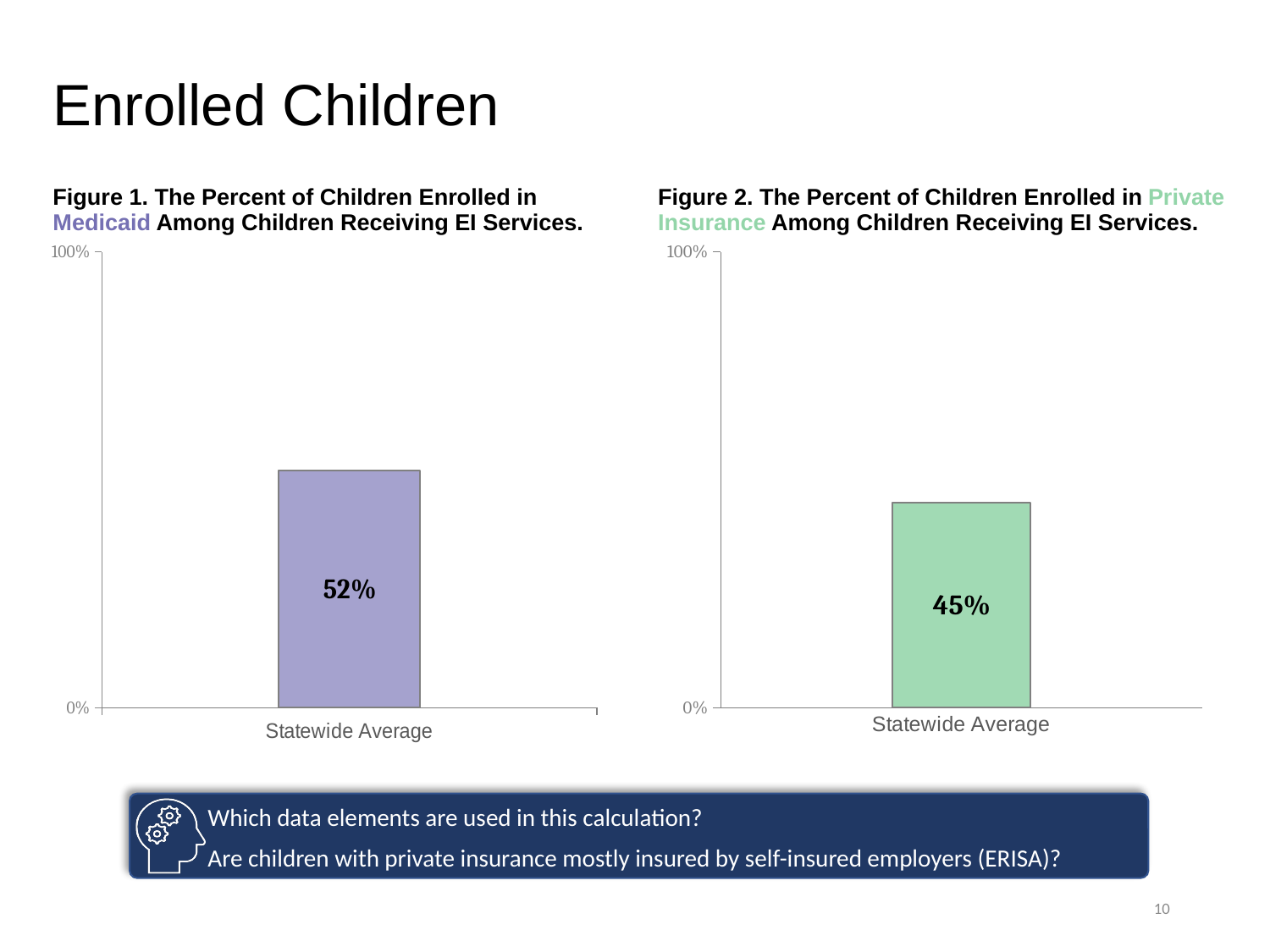
What is the title of the chart on the left? Figure 1. The Percent of Children Enrolled in Medicaid Among Children Receiving EI Services. Which is larger: the Statewide Average in Figure 1 or the Statewide Average in Figure 2? Figure 1 How many categories are plotted in Figure 2? 1 What kind of chart is Figure 2? Bar chart What is the difference between the Statewide Average in Figure 1 and the Statewide Average in Figure 2? 7% How many categories are plotted in Figure 1? 1 In Figure 1, is the value for Statewide Average greater or less than 100%? less What colour is the bar in Figure 2? Green In Figure 2, what is the value for Statewide Average? 45% In Figure 1, what is the value for Statewide Average? 52% In Figure 2, is the value for Statewide Average greater or less than 0%? greater What kind of chart is Figure 1? Bar chart